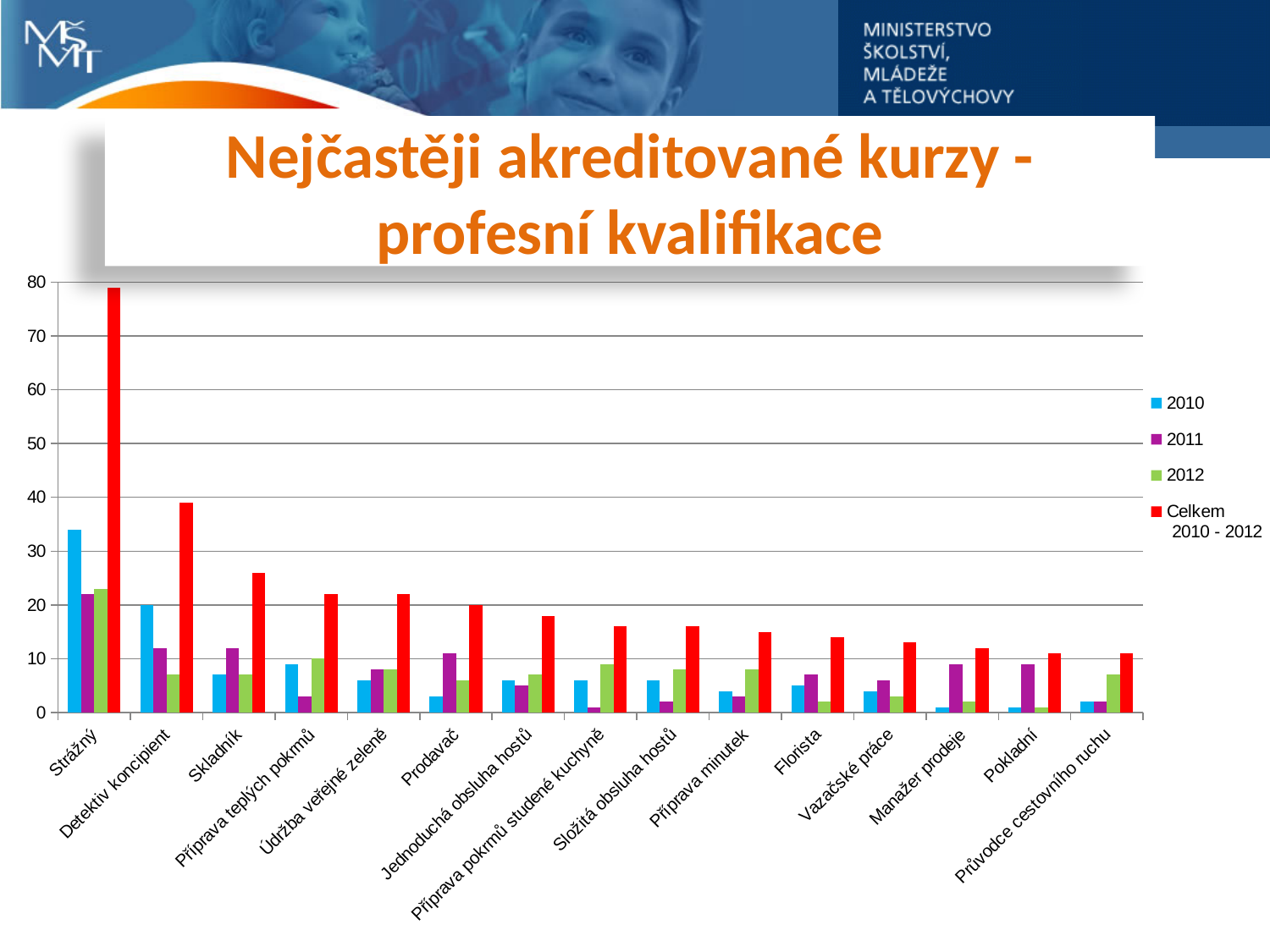
Do the values for the series Celkem 2010 - 2012 generally rise or fall from left to right along the x axis? fall Is the value for Skladník in the series Celkem 2010 - 2012 greater or less than 30? less Which is larger for the series 2010: Strážný or Skladník? Strážný Is the value for Strážný in the series 2010 greater or less than 30? greater Which category has the highest value for the series Celkem 2010 - 2012? Strážný Is the value for Strážný in the series Celkem 2010 - 2012 greater or less than 70? greater How many categories are shown on the x axis? 15 What is the title of the chart on the slide? Nejčastěji akreditované kurzy - profesní kvalifikace What kind of chart is shown on the slide? bar chart Which is larger for the series Celkem 2010 - 2012: Strážný or Detektiv koncipient? Strážný How many series does the legend list? 4